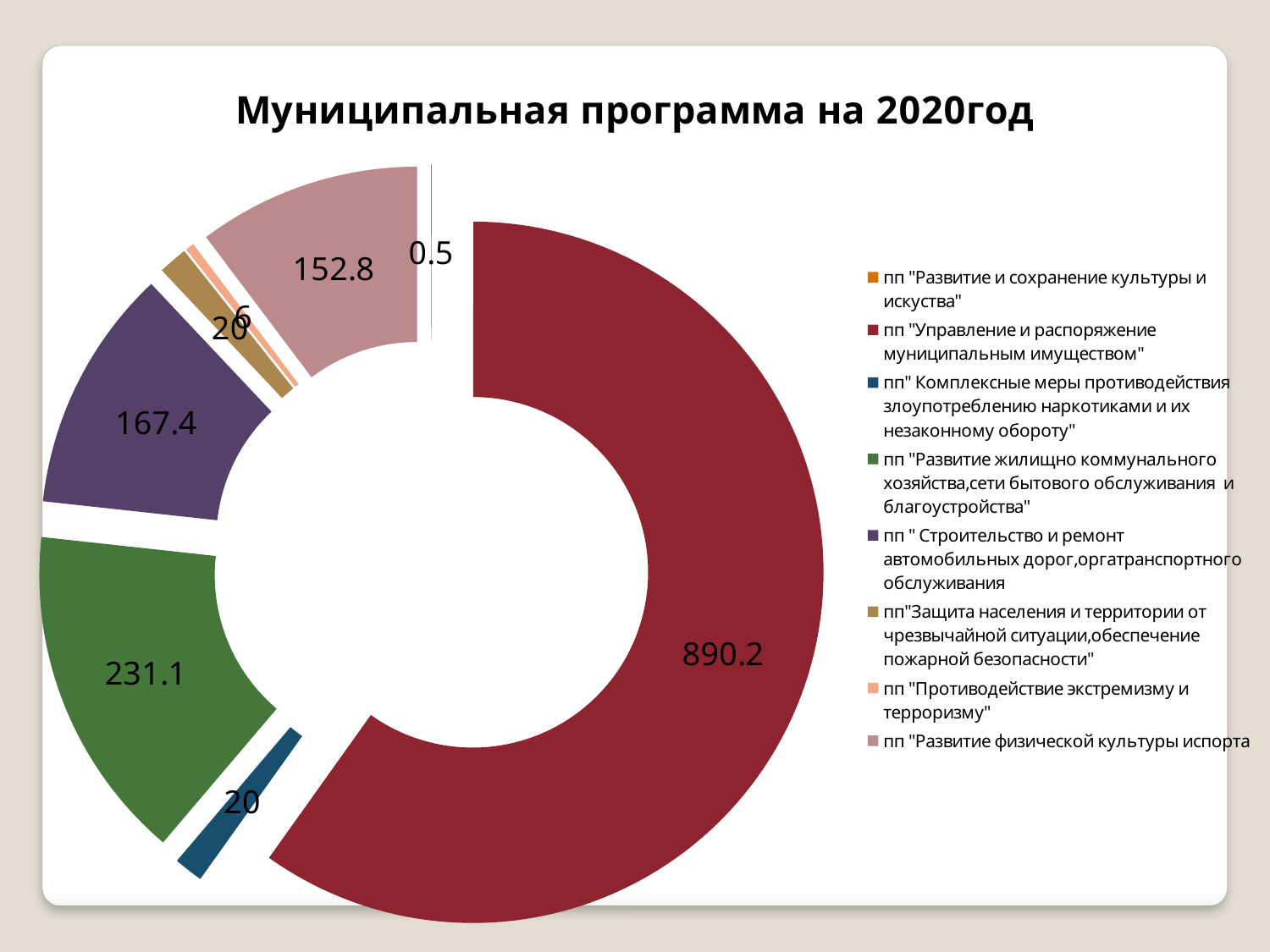
Which category has the smallest slice? пп "Развитие и сохранение культуры и искуства" What is the value for пп "Управление и распоряжение муниципальным имуществом"? 890.2 Which category has the largest slice? пп "Управление и распоряжение муниципальным имуществом" What kind of chart is shown on the slide? doughnut (pie) chart How many categories does the legend list? 8 What is the value for пп "Строительство и ремонт автомобильных дорог,оргатранспортного обслуживания"? 167.4 What is the value for пп "Развитие жилищно коммунального хозяйства,сети бытового обслуживания и благоустройства"? 231.1 What is the title of the chart? Муниципальная программа на 2020год What is the value for пп "Комплексные меры противодействия злоупотреблению наркотиками и их незаконному обороту"? 20 What is the difference between the value for пп "Развитие жилищно коммунального хозяйства..." and the value for пп "Строительство и ремонт автомобильных дорог..."? 63.7 What is the value for пп "Развитие физической культуры испорта"? 152.8 What is the value for пп "Развитие и сохранение культуры и искуства"? 0.5